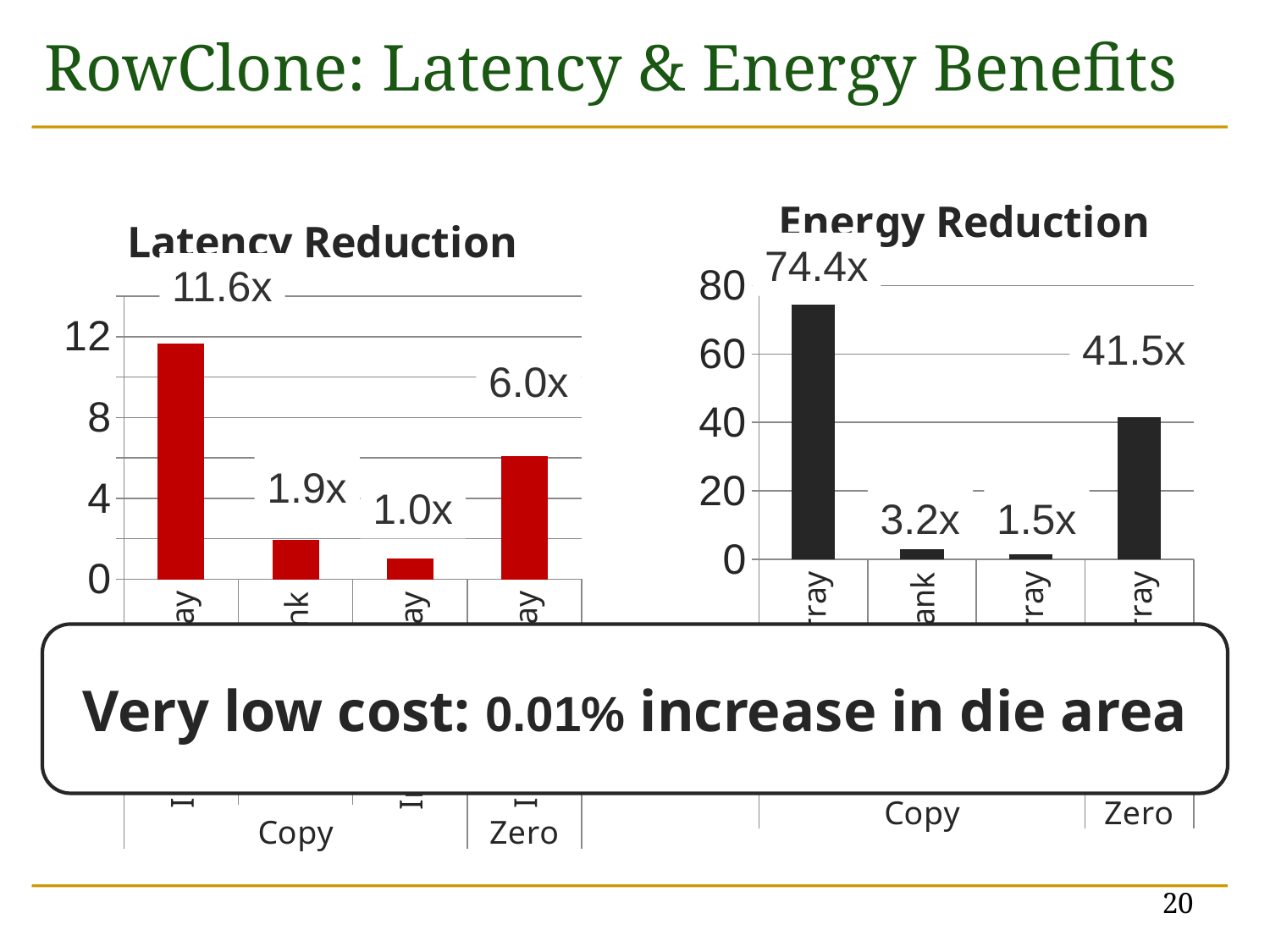
In the Energy Reduction chart, what is the highest labelled value? 74.4x In the Energy Reduction chart, what value is labelled on the first (leftmost) bar? 74.4x What type of chart is the Energy Reduction chart? Bar chart In the Energy Reduction chart, which is larger: the second bar (3.2x) or the third bar (1.5x)? 3.2x In the Energy Reduction chart, what is the lowest labelled value? 1.5x In the Latency Reduction chart, what value is labelled on the first (leftmost) bar? 11.6x In the Energy Reduction chart, what is the difference between the first bar's value (74.4x) and the Zero bar's value (41.5x)? 32.9x In the Latency Reduction chart, what is the difference between the first bar's value (11.6x) and the Zero bar's value (6.0x)? 5.6x In the Latency Reduction chart, what is the lowest labelled value? 1.0x How many bars are plotted in the Latency Reduction chart? 4 In the Latency Reduction chart, what value is labelled on the bar in the Zero group? 6.0x In the Energy Reduction chart, what value is labelled on the bar in the Zero group? 41.5x